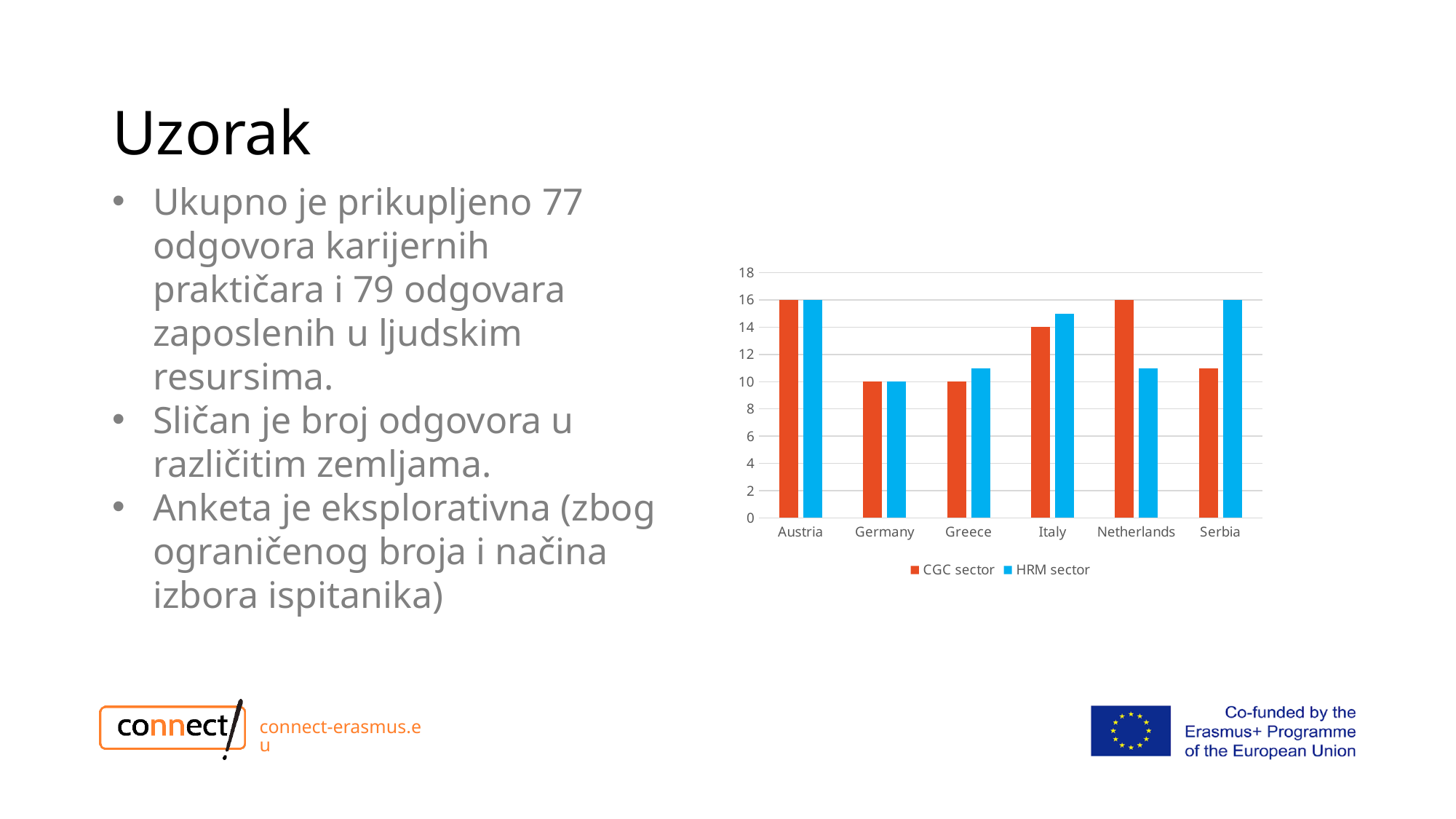
How many series does the chart legend list? 2 What is the value for the CGC sector in Austria? 16 What is the difference between the CGC sector values for Austria and Germany? 6 In the Netherlands, which series has the larger value, CGC sector or HRM sector? CGC sector In Serbia, which series has the larger value, CGC sector or HRM sector? HRM sector What is the value for the HRM sector in Germany? 10 Is the value for the HRM sector in the Netherlands greater or less than 12? less What is the value for the CGC sector in Italy? 14 What is the value for the HRM sector in Serbia? 16 How many countries are shown on the x axis of the chart? 6 What are the two series named in the chart legend? CGC sector and HRM sector What type of chart is shown on the slide? bar chart